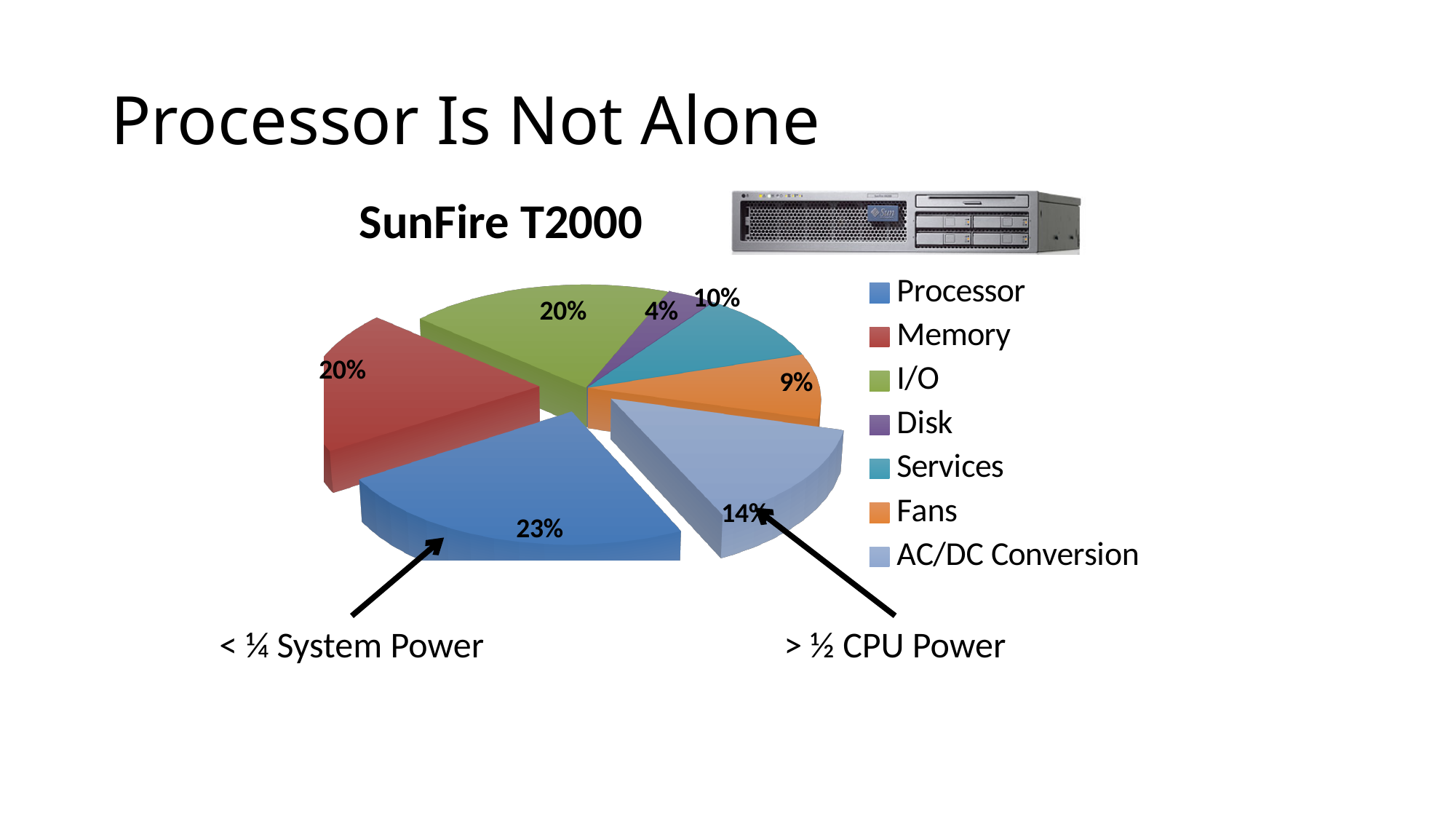
Which category has the largest slice in the SunFire T2000 pie chart? Processor Which category is shown in green in the SunFire T2000 pie chart? I/O By how many percentage points does the Processor slice exceed the AC/DC Conversion slice in the SunFire T2000 pie chart? 9 percentage points Which category has the smallest slice in the SunFire T2000 pie chart? Disk What percentage is shown for AC/DC Conversion in the SunFire T2000 pie chart? 14% What kind of chart is shown on the slide? Pie chart What percentage is shown for Memory in the SunFire T2000 pie chart? 20% How many categories are shown in the SunFire T2000 pie chart? 7 In the SunFire T2000 pie chart, which is larger: Services or Fans? Services What is the title of the chart on the slide? SunFire T2000 What percentage is shown for Fans in the SunFire T2000 pie chart? 9% What share of the SunFire T2000 pie chart does the Processor slice represent? 23%